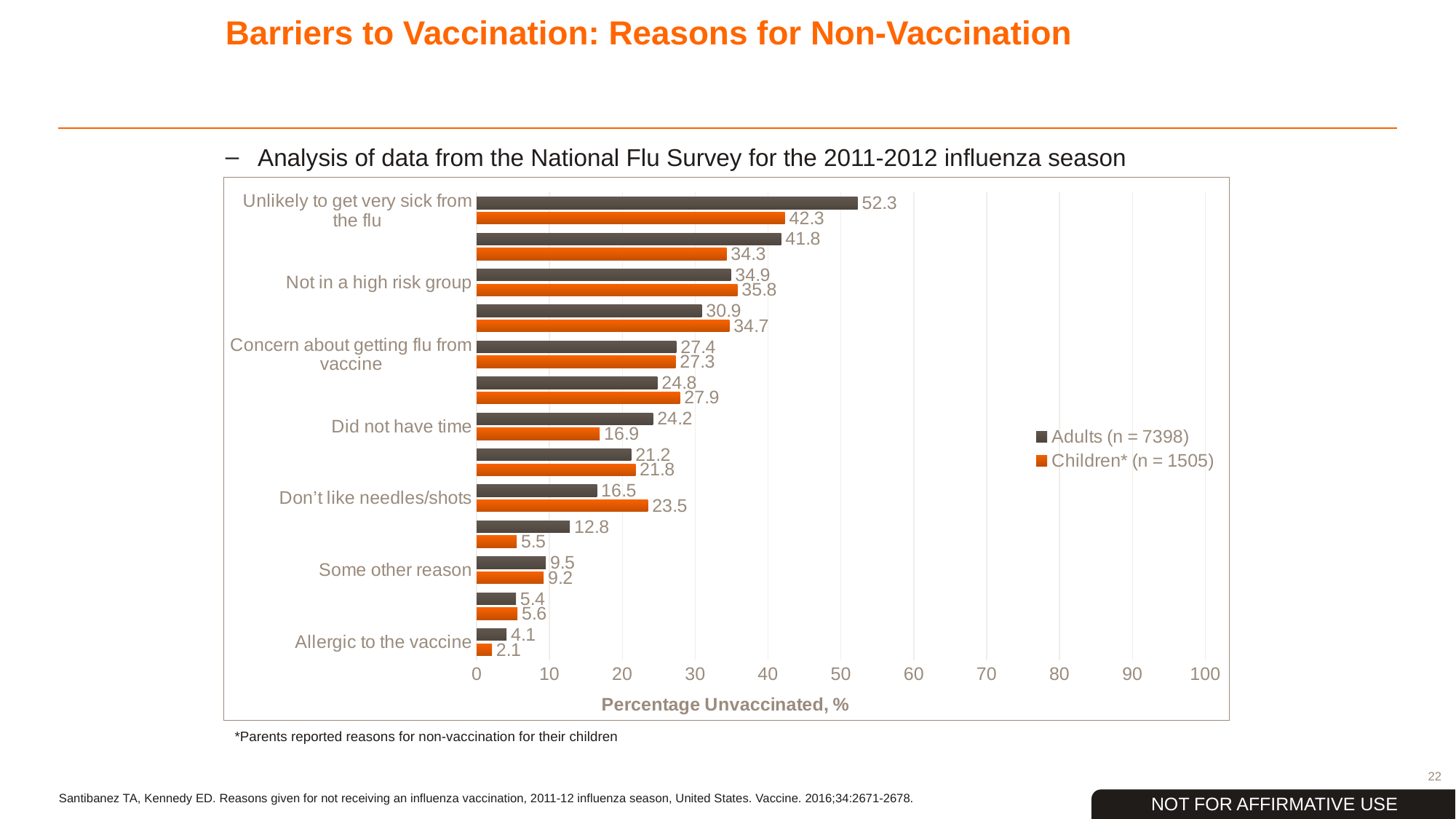
Is the Adults value for 'Not in a high risk group' greater or less than 30? greater What is the value for Adults for 'Unlikely to get very sick from the flu'? 52.3 Which labelled reason has the highest value for Adults? Unlikely to get very sick from the flu What is the difference between the Adults and Children values for 'Unlikely to get very sick from the flu'? 10.0 What type of chart is shown on the slide? Bar chart What is the value for Children for 'Did not have time'? 16.9 Which labelled reason has the lowest value for Children? Allergic to the vaccine What is the difference between the Adults and Children values for 'Did not have time'? 7.3 What is the value for Children for 'Don't like needles/shots'? 23.5 How many series does the legend list? 2 What is the value for Adults for 'Allergic to the vaccine'? 4.1 For 'Don't like needles/shots', which is larger: the Adults value or the Children value? Children